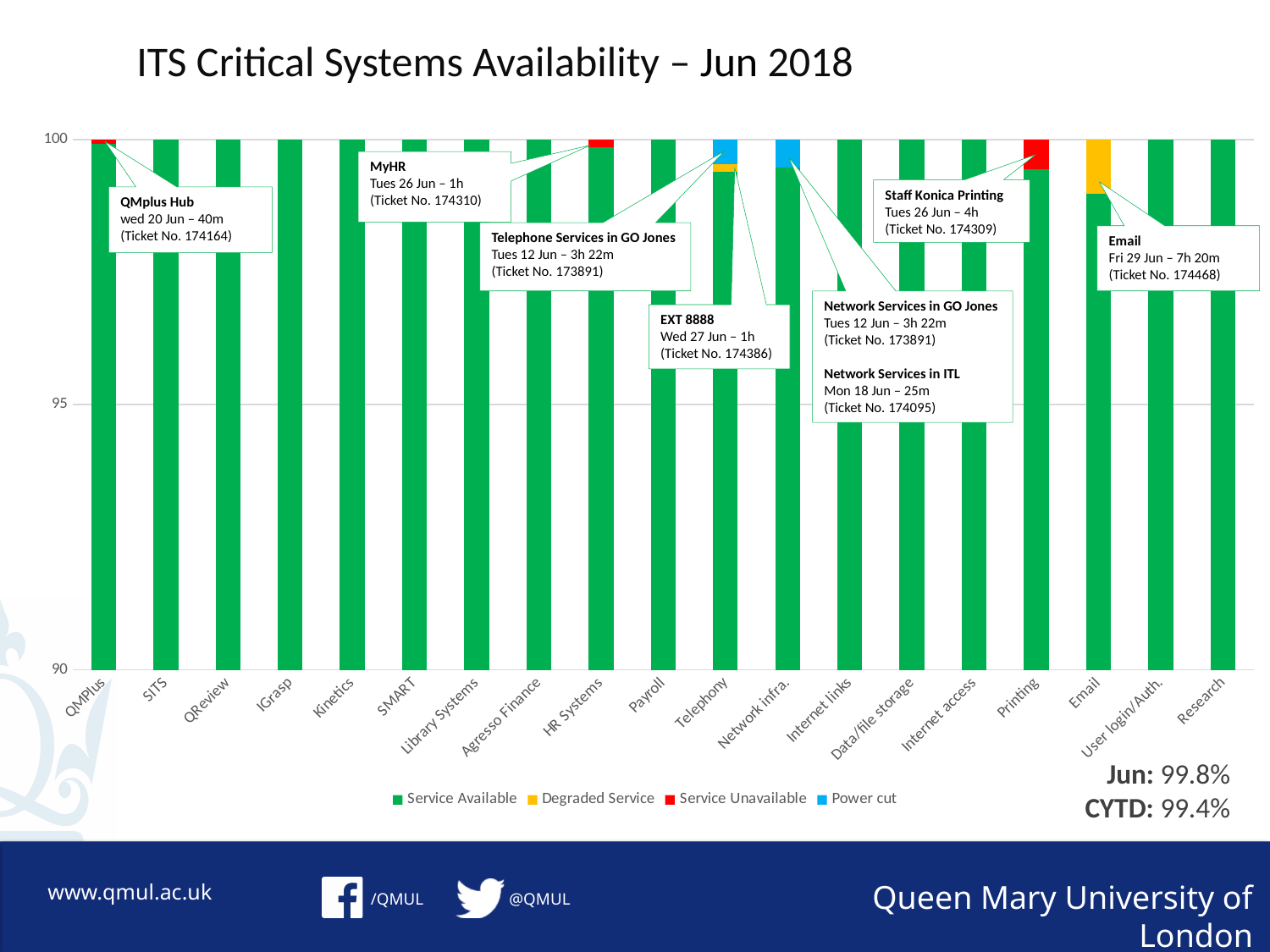
What is the title of the chart? ITS Critical Systems Availability – Jun 2018 Is the Service Available value for Printing greater or less than 95? greater Which category has the largest Degraded Service segment? Email How many series does the chart's legend list? 4 What overall availability figure is given for Jun on the slide? 99.8% Is the Service Available value for Email greater or less than 95? greater What kind of chart is shown on the slide? Bar chart How many categories (systems) are shown along the x axis of the chart? 19 Is the Service Available value for SITS greater or less than 95? greater Which categories show a Service Unavailable segment in the chart? QMPlus, HR Systems and Printing Which categories show a Power cut segment in the chart? Telephony and Network infra.